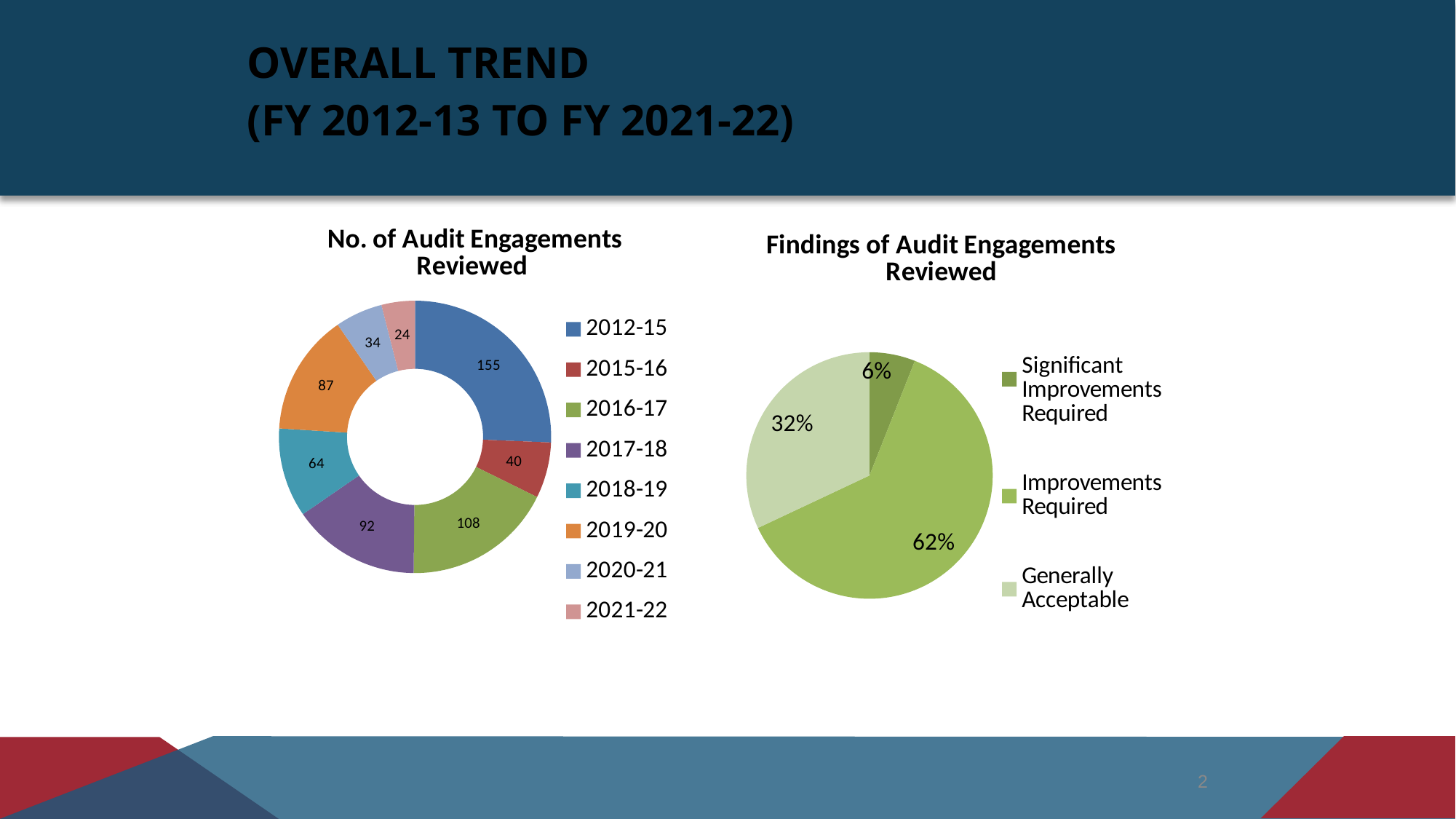
In the 'No. of Audit Engagements Reviewed' chart, which period has the highest number of audit engagements reviewed? 2012-15 In the 'Findings of Audit Engagements Reviewed' chart, what share of findings is 'Generally Acceptable'? 32% In the 'No. of Audit Engagements Reviewed' chart, what is the value for 2017-18? 92 In the 'No. of Audit Engagements Reviewed' chart, which is larger: the value for 2019-20 or the value for 2018-19? 2019-20 In the 'No. of Audit Engagements Reviewed' chart, what is the value for 2012-15? 155 In the 'No. of Audit Engagements Reviewed' chart, which period has the lowest number of audit engagements reviewed? 2021-22 In the 'Findings of Audit Engagements Reviewed' chart, which category has the largest share? Improvements Required What kind of chart is the 'No. of Audit Engagements Reviewed' chart? Doughnut chart In the 'Findings of Audit Engagements Reviewed' chart, what share of findings is 'Significant Improvements Required'? 6% In the 'No. of Audit Engagements Reviewed' chart, what is the difference between the values for 2016-17 and 2015-16? 68 How many periods are shown in the 'No. of Audit Engagements Reviewed' chart? 8 How many categories does the legend of the 'Findings of Audit Engagements Reviewed' chart list? 3